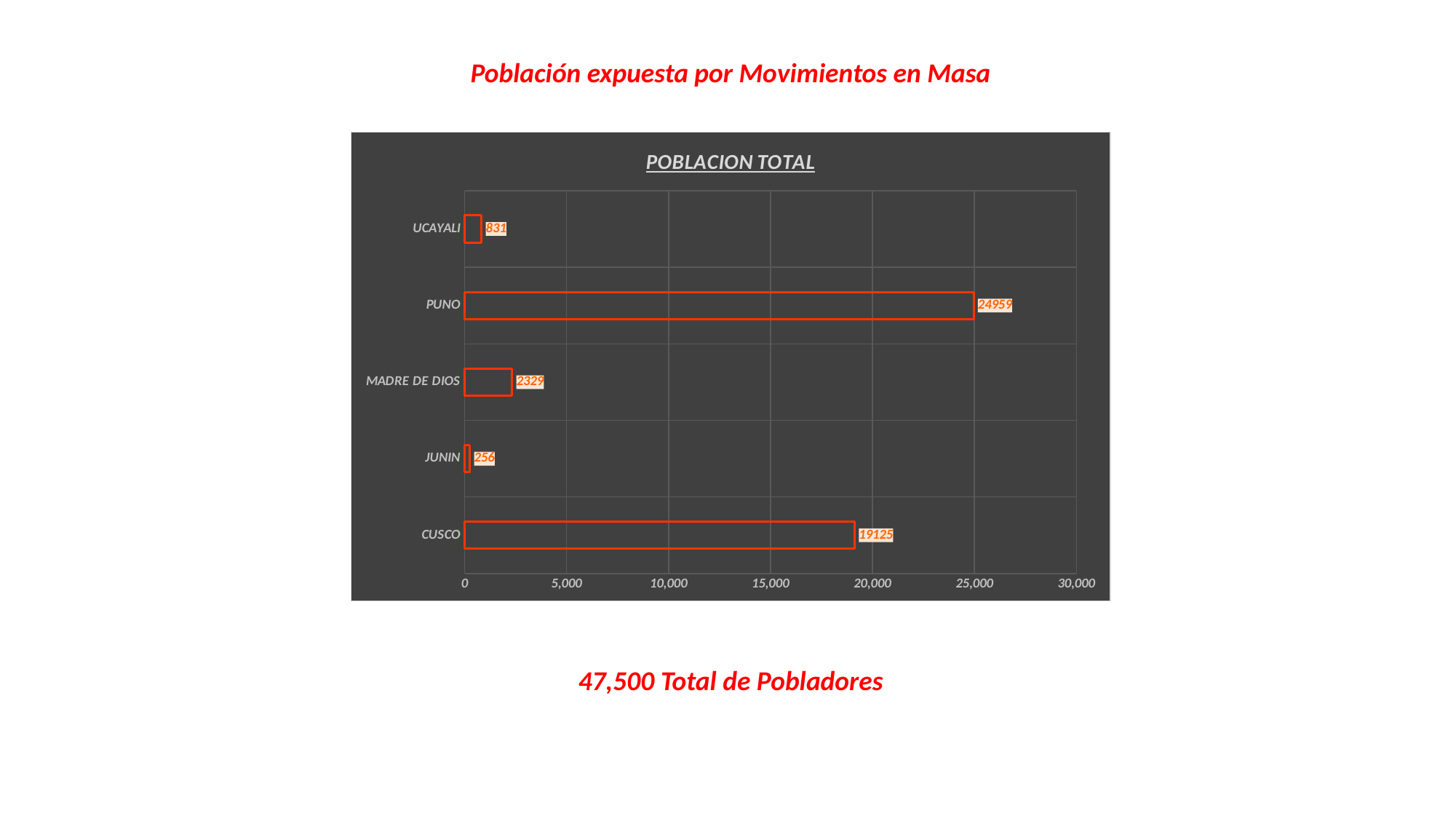
Which category has the lowest value? JUNIN What is the value for PUNO? 24959 What is the difference between the values for PUNO and CUSCO? 5834 What is the value for MADRE DE DIOS? 2329 Which is larger, the value for MADRE DE DIOS or the value for UCAYALI? MADRE DE DIOS How many categories are shown in the chart? 5 Which category has the highest value? PUNO What is the value for UCAYALI? 831 What kind of chart is shown? Bar chart What is the value for CUSCO? 19125 What is the title of the chart? POBLACION TOTAL What is the value for JUNIN? 256